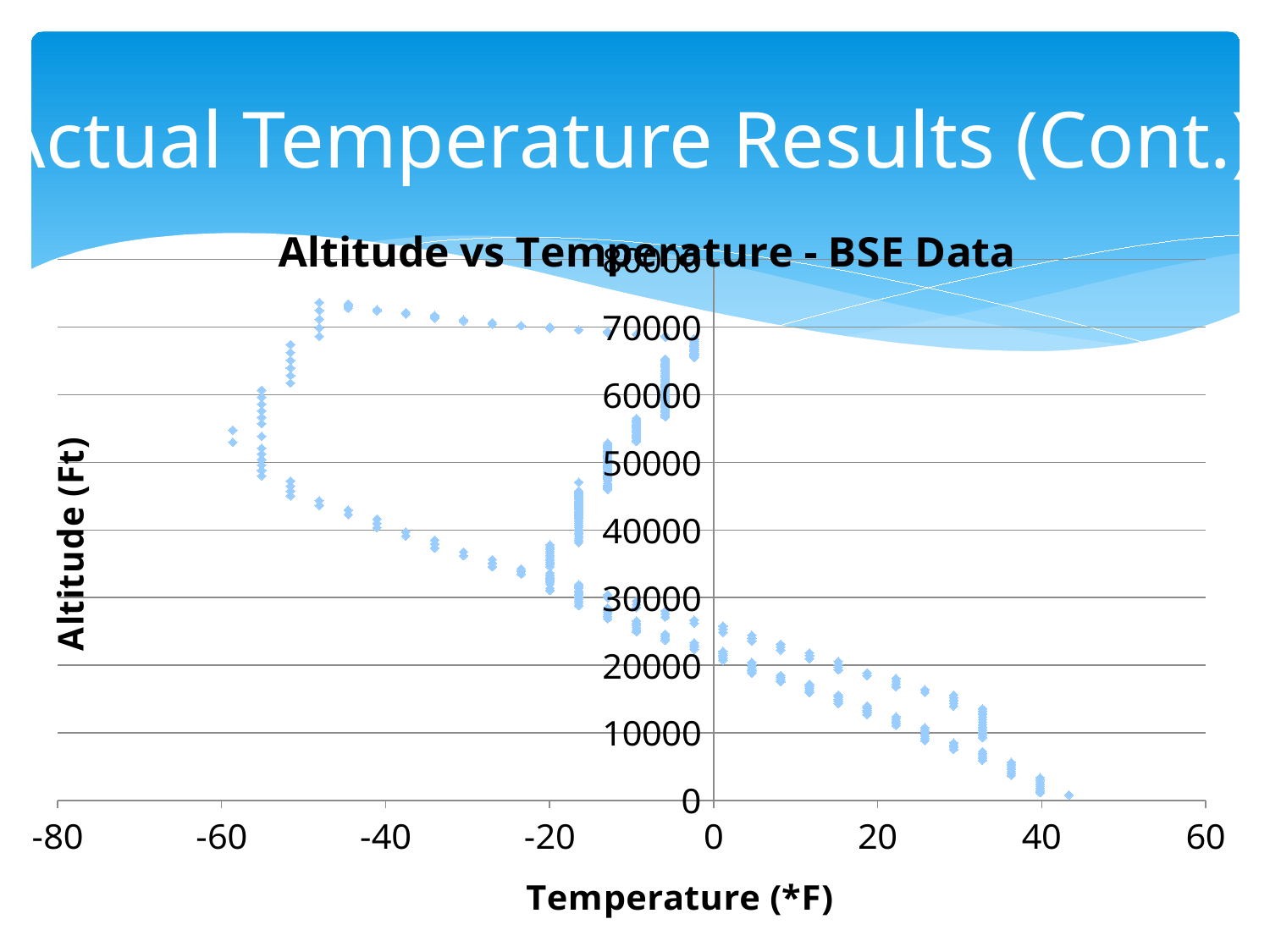
What is the label of the vertical axis? Altitude (Ft) What is the highest value shown on the vertical axis? 80000 Is the lowest temperature plotted greater or less than -40? less What is the title of the chart? Altitude vs Temperature - BSE Data What kind of chart is shown on the slide? scatter chart Is the highest temperature plotted greater or less than 20? greater Is the highest altitude plotted greater or less than 70000? greater What is the highest value shown on the horizontal axis? 60 What is the lowest value shown on the horizontal axis? -80 Below about 30000 ft, do the plotted temperatures rise or fall as altitude increases? fall